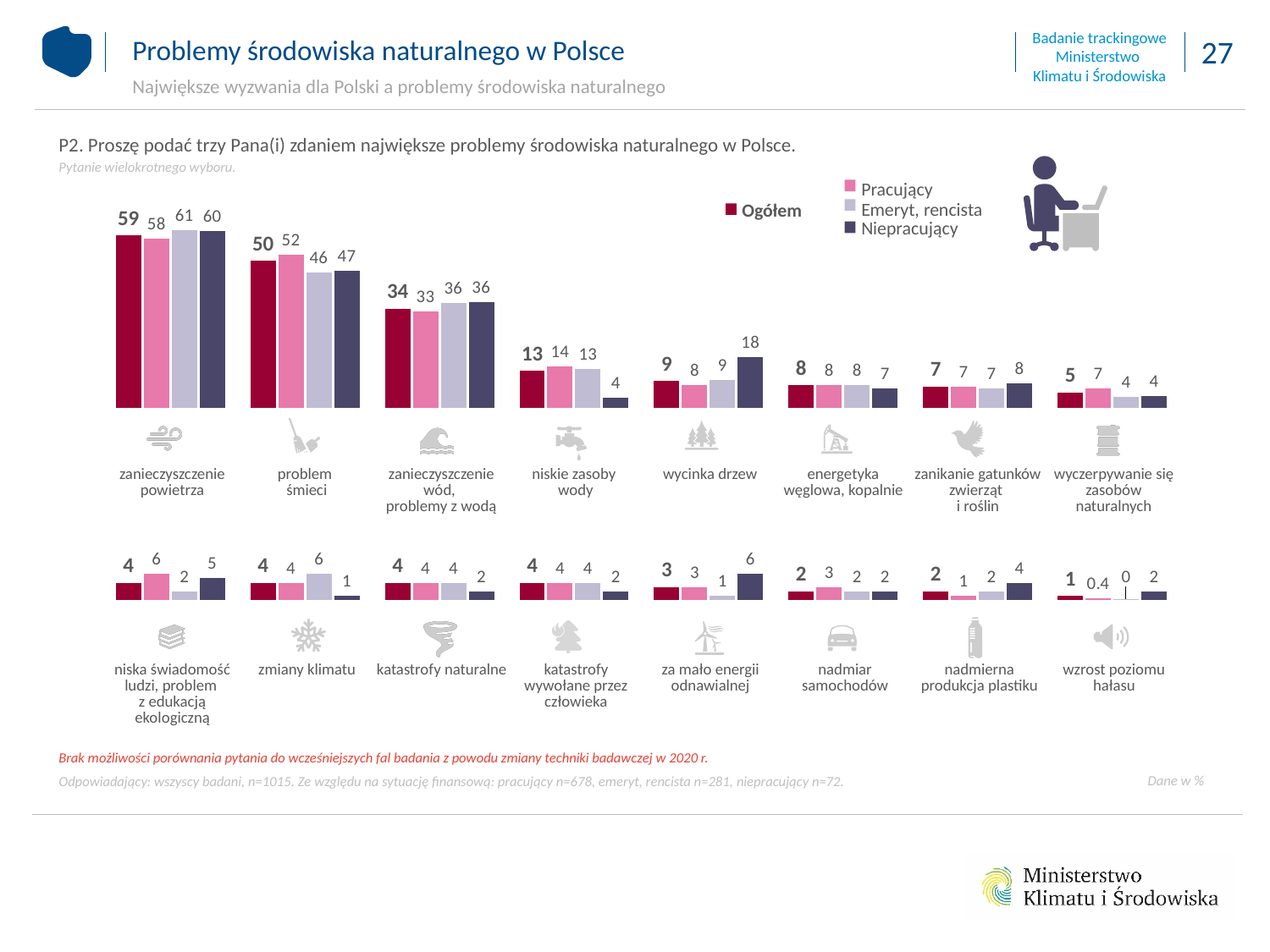
For zmiany klimatu, which is larger: the Emeryt, rencista value or the Niepracujący value? Emeryt, rencista What kind of chart is shown on the slide? bar chart How many series does the legend list? 4 Which category has the highest Ogółem value? zanieczyszczenie powietrza How many categories are shown in the chart? 16 Which category has the lowest Ogółem value? wzrost poziomu hałasu What is the difference between the Niepracujący and Ogółem values for niskie zasoby wody? 9 What is the Emeryt, rencista value for problem śmieci? 46 What is the Niepracujący value for wycinka drzew? 18 What is the Ogółem value for zanieczyszczenie powietrza? 59 Which series is shown in dark red in the legend? Ogółem What is the Pracujący value for wzrost poziomu hałasu? 0.4